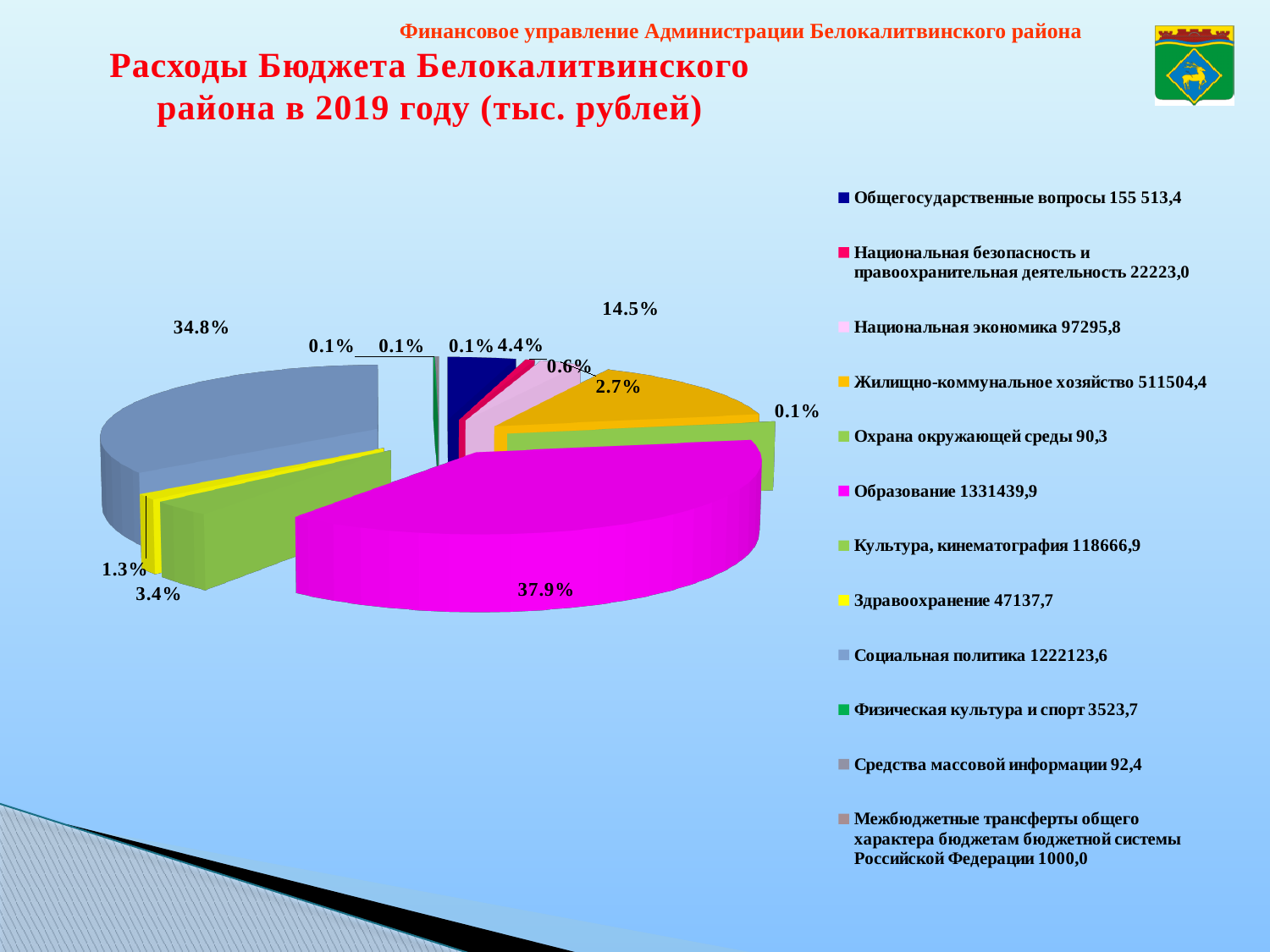
What value is shown in the legend for Здравоохранение? 47137,7 What kind of chart is shown on the slide? Pie chart What share of the pie does Жилищно-коммунальное хозяйство represent? 14.5% What is the title of the chart on the slide? Расходы Бюджета Белокалитвинского района в 2019 году (тыс. рублей) Which is larger: Образование or Социальная политика? Образование Which category has the largest value in the pie chart? Образование What share of the pie does Социальная политика represent? 34.8% Which category has the smallest value according to the legend? Охрана окружающей среды How many categories does the legend of the pie chart list? 12 What value is shown in the legend for Образование? 1331439,9 What is the difference between the values for Образование and Социальная политика? 109316,3 What value is shown in the legend for Жилищно-коммунальное хозяйство? 511504,4